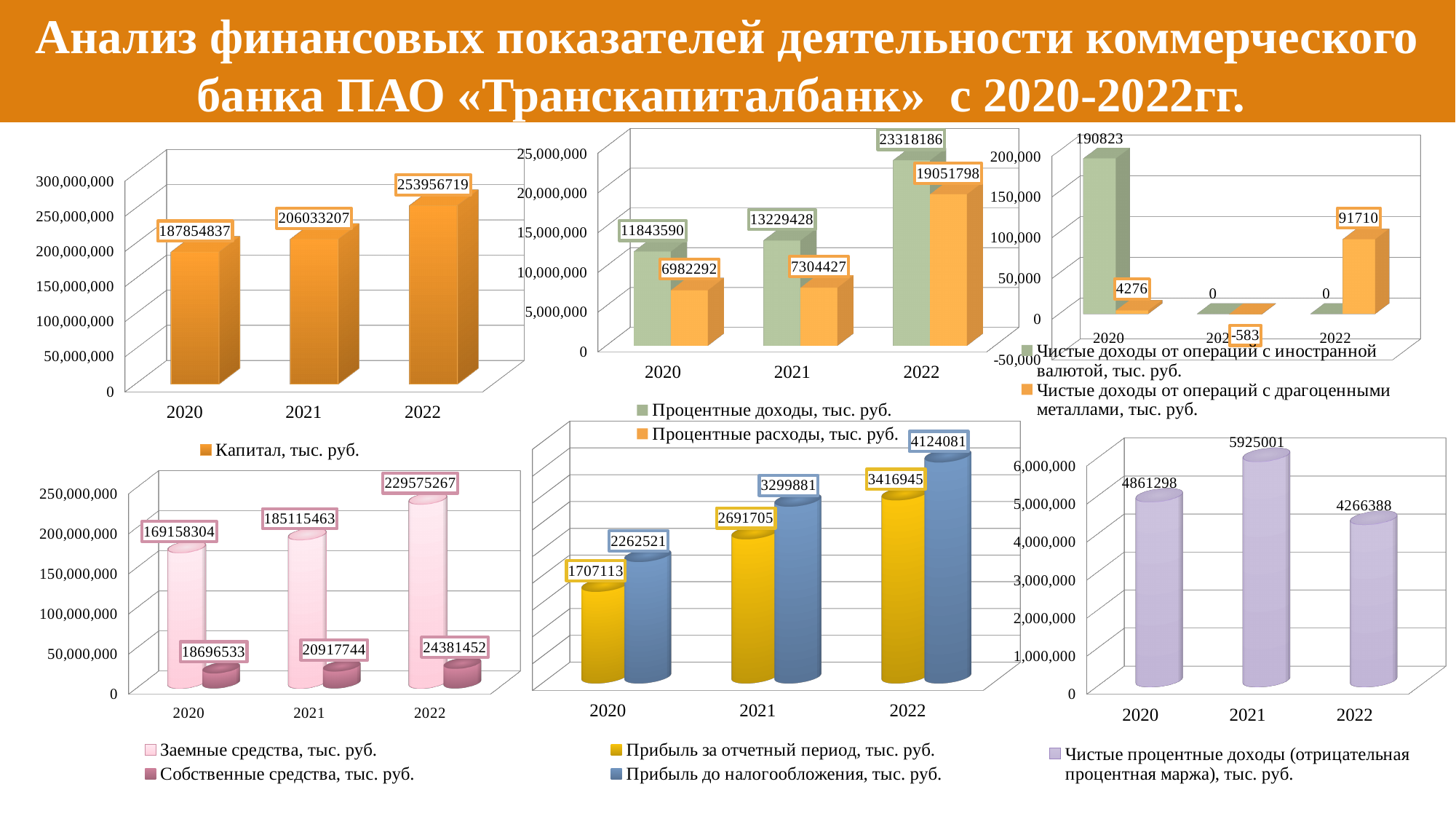
In the top-middle chart, what is the difference between Процентные доходы and Процентные расходы for 2022? 4266388 In the top-left chart (Капитал, тыс. руб.), which year has the lowest value? 2020 In the top-right chart, what is the value of Чистые доходы от операций с иностранной валютой, тыс. руб. for 2020? 190823 In the bottom-middle chart, what is the difference between Прибыль до налогообложения and Прибыль за отчетный период for 2020? 555408 In the bottom-middle chart, which is larger for 2021: Прибыль за отчетный период or Прибыль до налогообложения? Прибыль до налогообложения In the top-middle chart, what is the value of Процентные расходы, тыс. руб. for 2021? 7304427 In the bottom-left chart, do the values of Заемные средства, тыс. руб. rise or fall from 2020 to 2022? rise In the top-right chart, what is the value of Чистые доходы от операций с драгоценными металлами, тыс. руб. for 2021? -583 In the bottom-right chart (Чистые процентные доходы), which year has the highest value? 2021 In the bottom-left chart, what is the value of Собственные средства, тыс. руб. for 2022? 24381452 In the top-left chart (Капитал, тыс. руб.), what is the value for 2022? 253956719 How many series does the legend of the bottom-left chart list? 2